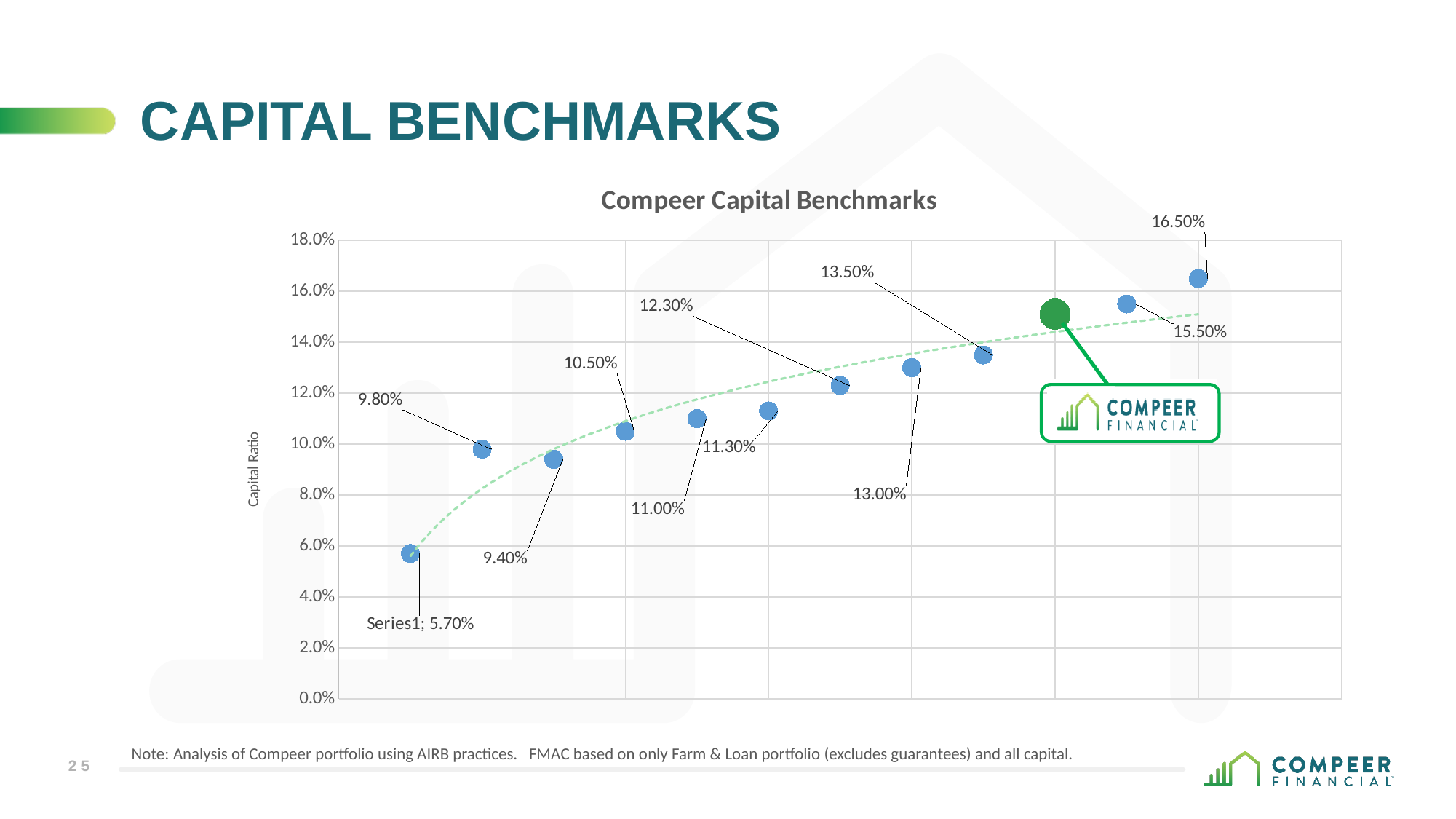
Which is larger, the point labeled 9.80% or the point labeled 9.40%? 9.80% What is the value of the rightmost data point on the chart? 16.50% What is the title of the chart? Compeer Capital Benchmarks What is the value of the leftmost data point, labeled Series1? 5.70% What is the difference between the highest labeled value (16.50%) and the lowest labeled value (5.70%)? 10.80% Do the plotted values generally rise or fall from left to right along the x axis? rise What is the lowest labeled value on the chart? 5.70% How many data points are plotted on the chart, including the green one? 12 What is the highest labeled value on the chart? 16.50% What is the label on the vertical axis of the chart? Capital Ratio Is the value of the green highlighted data point greater or less than 14.0%? greater What kind of chart is shown on the slide? scatter chart